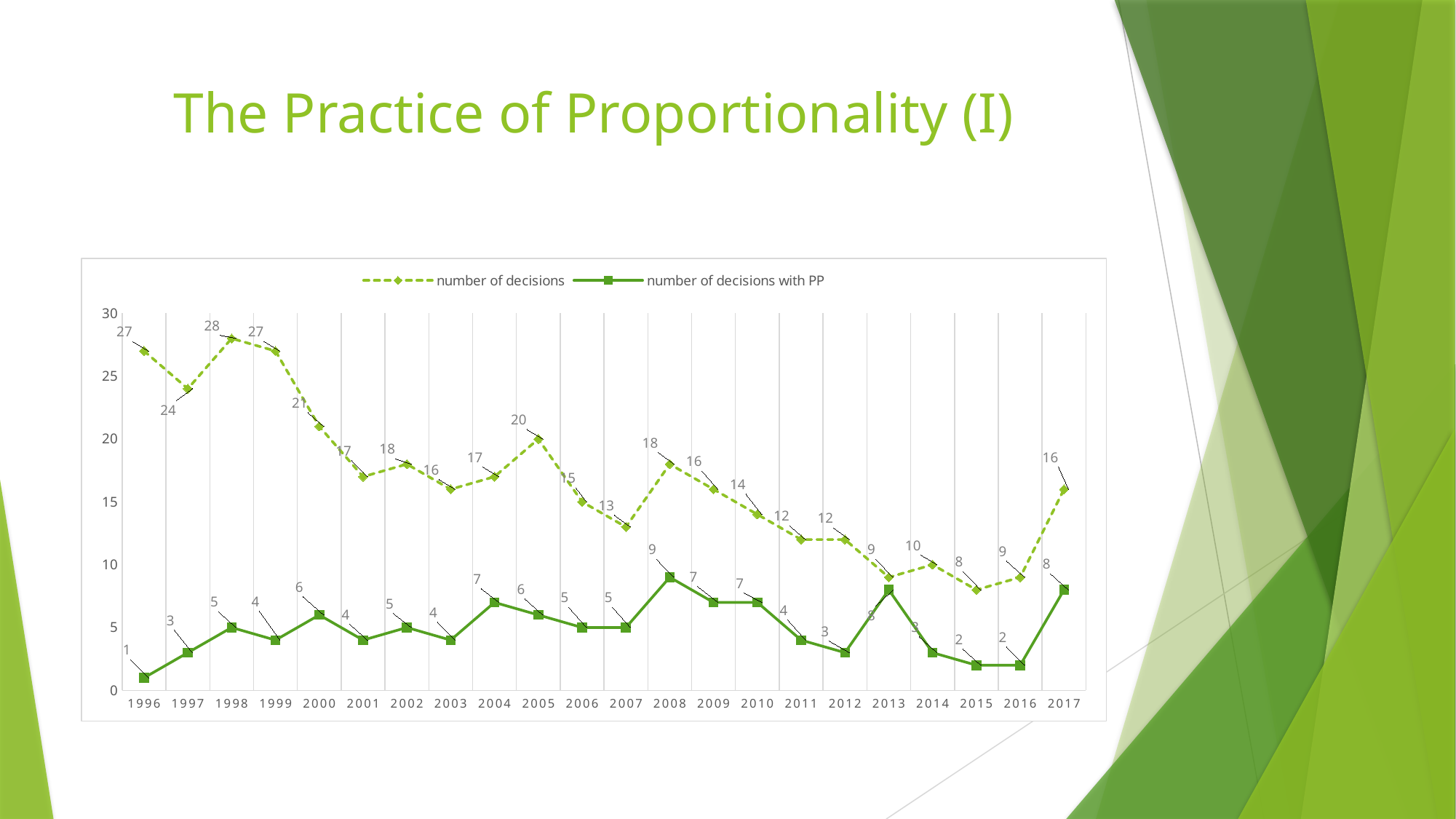
In which year is the number of decisions with PP highest? 2008 What is the number of decisions with PP in 2013? 8 Which is larger: the number of decisions in 2000 or in 2008? 2000 What is the number of decisions in 2005? 20 In which year is the number of decisions highest? 1998 Does the number of decisions generally rise or fall from 1996 to 2015? fall What is the difference between the number of decisions and the number of decisions with PP in 2017? 8 What type of chart is shown on the slide? line chart How many series does the legend list? 2 In which year is the number of decisions with PP lowest? 1996 How many years are plotted along the x axis? 22 In which year is the number of decisions lowest? 2015